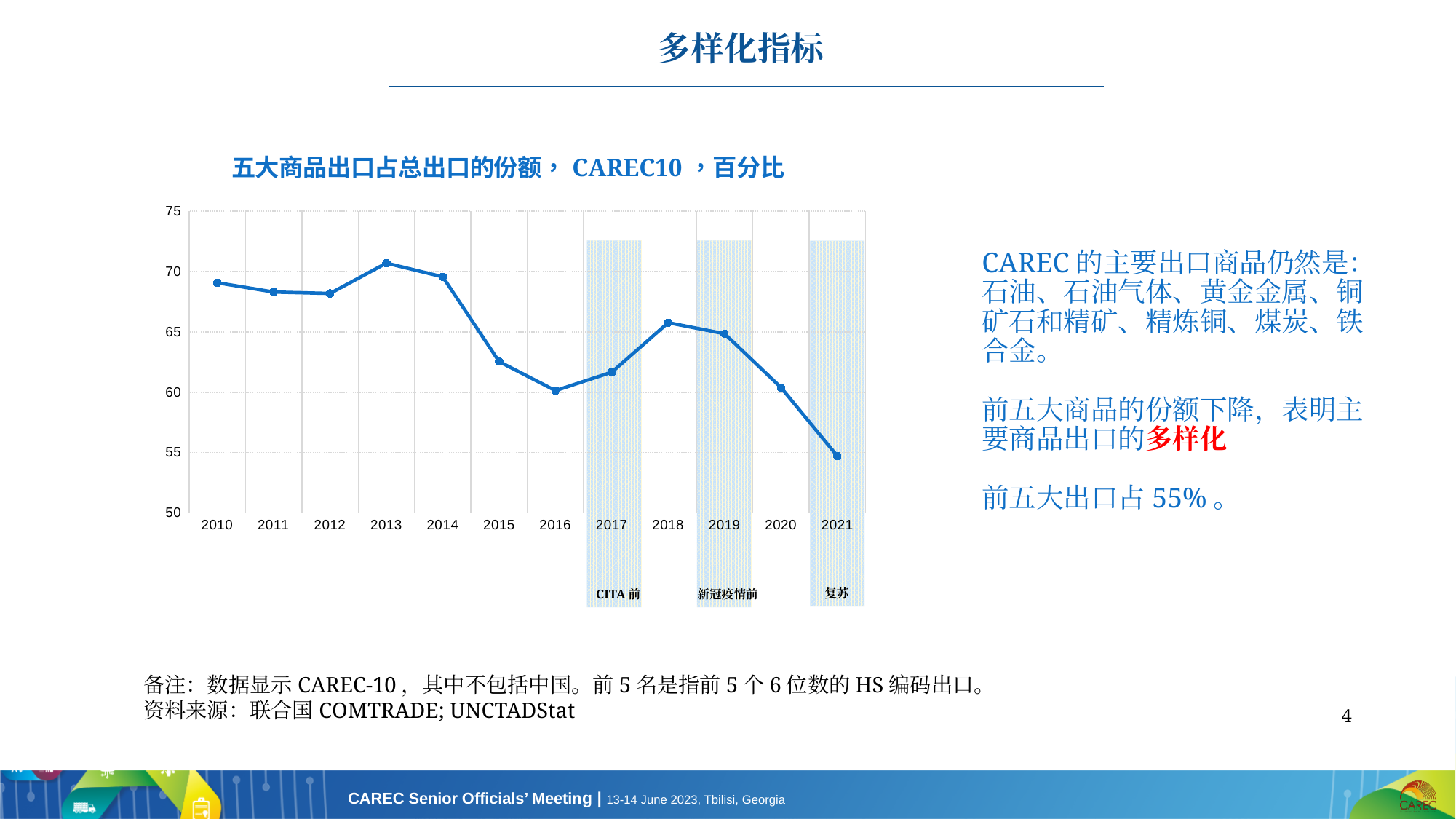
Which year has the highest share of the top five commodity exports in the chart? 2013 How many years are plotted on the x axis of the chart? 12 Which is larger, the value for 2013 or the value for 2016? 2013 Is the value for 2015 greater or less than 60? greater What kind of chart is shown on the slide? line chart Which year has the lowest share of the top five commodity exports in the chart? 2021 Which is larger, the value for 2018 or the value for 2020? 2018 Is the value for 2013 greater or less than 70? greater Is the value for 2017 greater or less than 65? less What label is shown under the shaded band for 2021 in the chart? 复苏 Overall, does the share of the top five commodity exports rise or fall from 2010 to 2021? fall